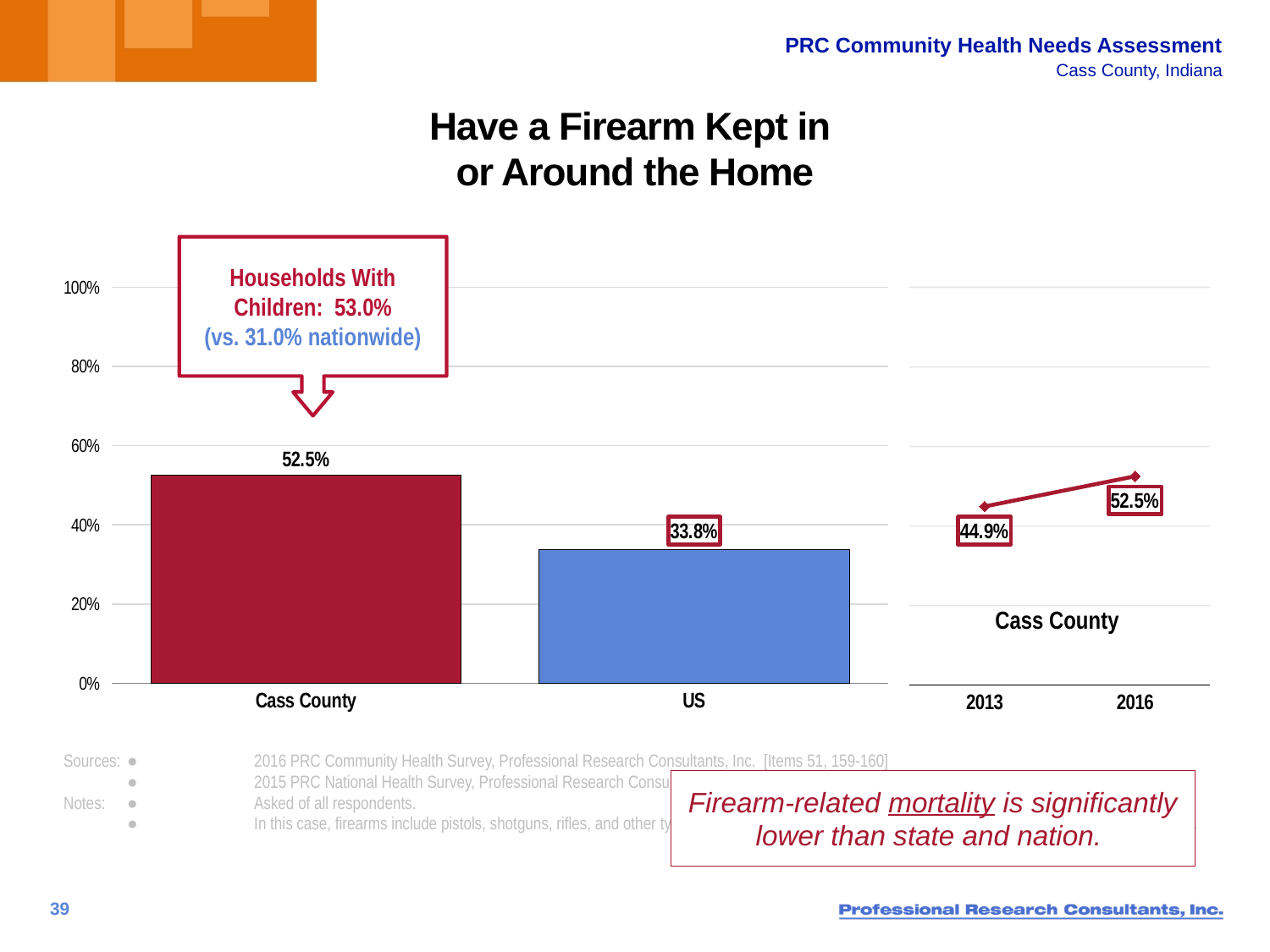
In the bar chart on the left, which category has the higher value, Cass County or US? Cass County What kind of chart is the chart on the left of the slide? Bar chart In the bar chart on the left, what is the value for US? 33.8% In the line chart on the right, what is the difference between the 2016 and 2013 values for Cass County? 7.6 percentage points What is the title of the chart on this slide? Have a Firearm Kept in or Around the Home In the bar chart on the left, what is the value for Cass County? 52.5% In the line chart on the right, what is the Cass County value for 2013? 44.9% In the bar chart on the left, how many categories are shown? 2 In the bar chart on the left, what is the difference between the Cass County value and the US value? 18.7 percentage points In the bar chart on the left, is the value for US greater or less than 40%? less In the line chart on the right, what is the Cass County value for 2016? 52.5% In the line chart on the right, does the Cass County value rise or fall from 2013 to 2016? Rise